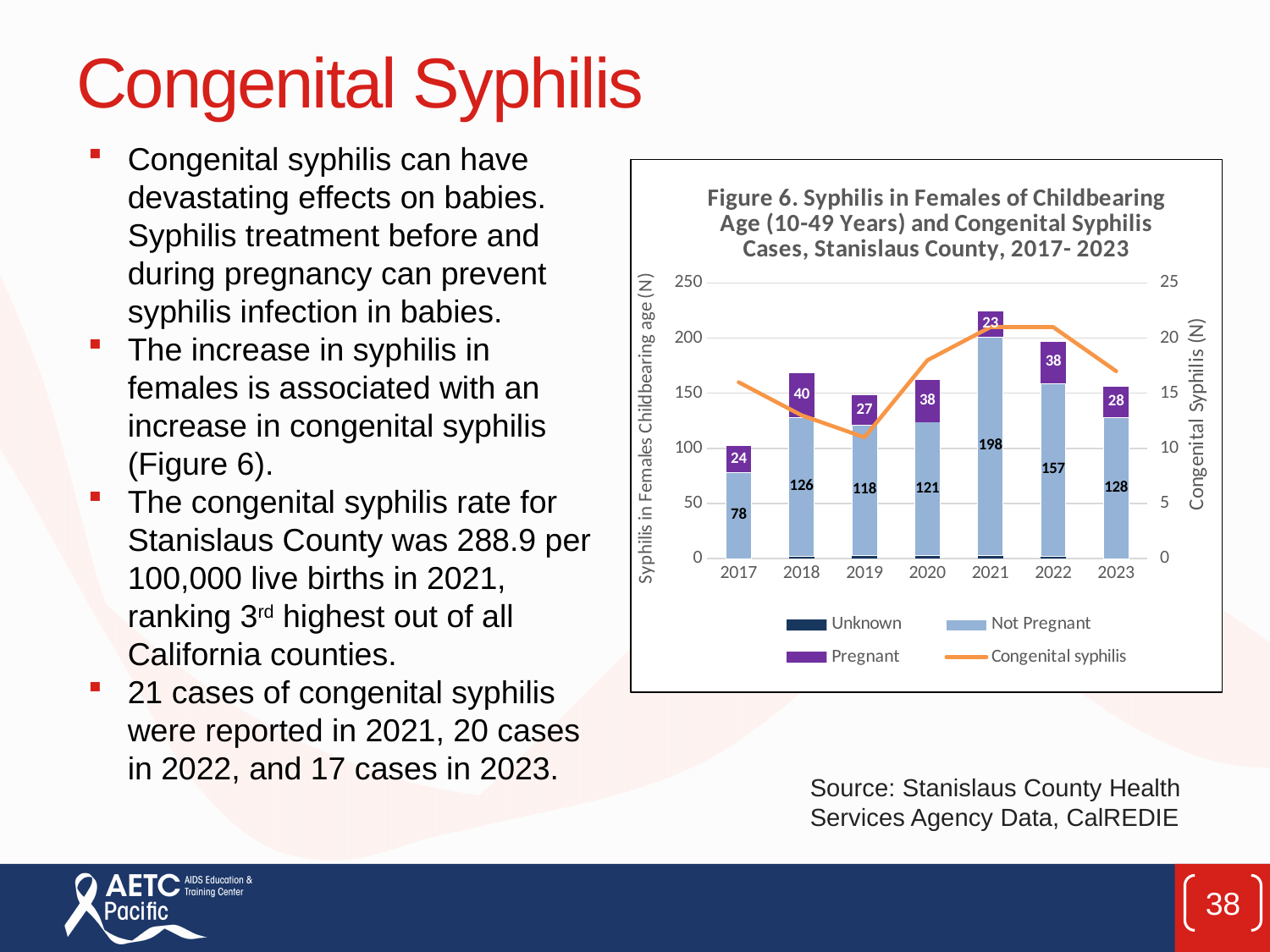
How many years are shown on the x axis? 7 Which year has the lowest Not Pregnant value? 2017 What is the Not Pregnant value for 2021? 198 What is the difference between the Not Pregnant values for 2021 and 2022? 41 Does the Not Pregnant value rise or fall from 2017 to 2021? rise Which year has the highest Not Pregnant value? 2021 What is the Pregnant value for 2018? 40 Is the Congenital syphilis value for 2021 greater or less than 15 on the right axis? greater Which year has the highest Pregnant value? 2018 How many series does the legend list? 4 What is the Not Pregnant value for 2023? 128 Which is larger, the Pregnant value for 2018 or for 2019? 2018